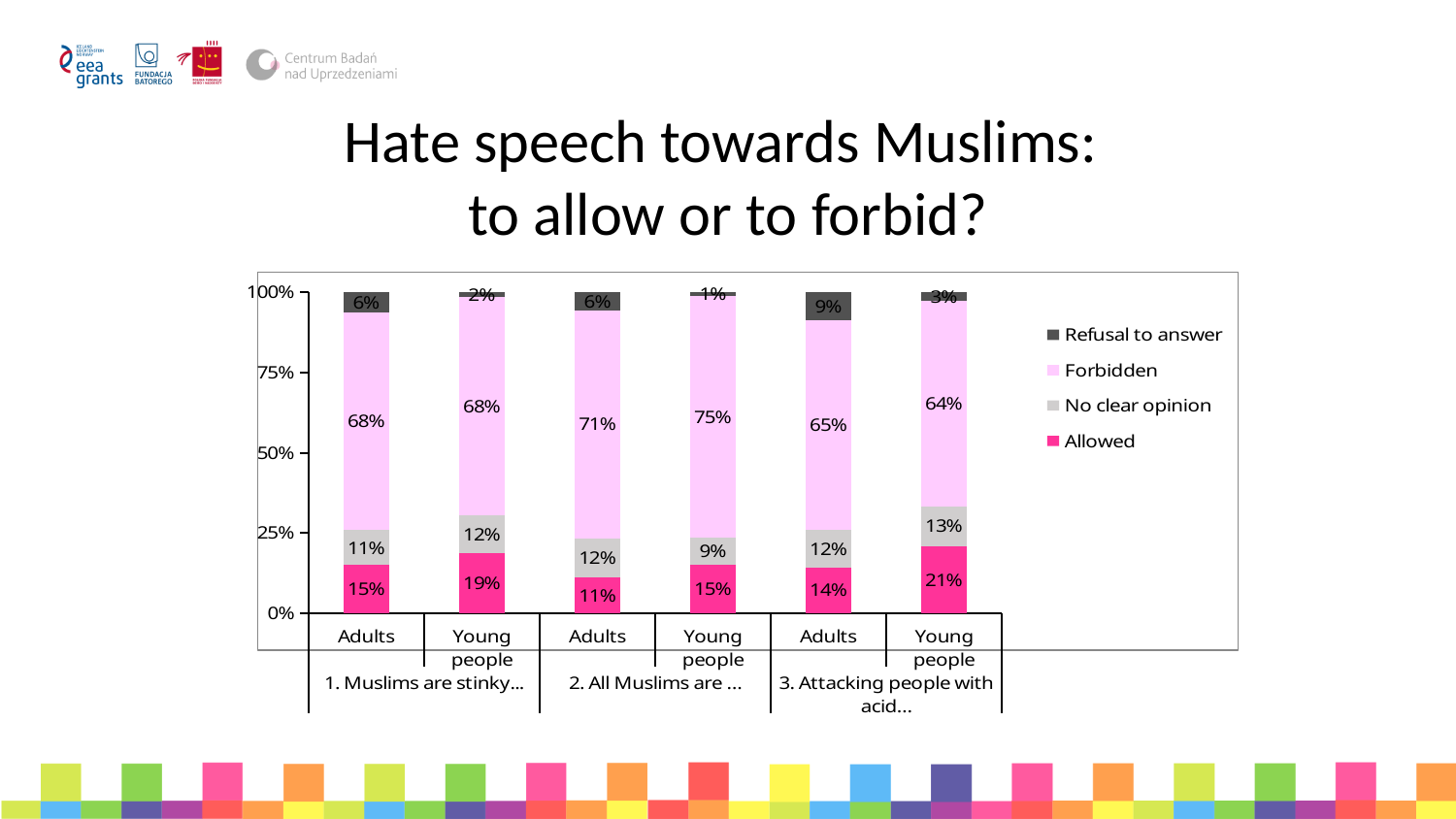
Which group and statement has the lowest 'Allowed' percentage? Adults, 2. All Muslims are ... For statement 2 ("All Muslims are ..."), who has the larger 'Forbidden' share, adults or young people? Young people How much higher is the 'Allowed' share for young people than for adults on statement 3 ("Attacking people with acid...")? 7 percentage points What percentage of young people said statement 3 ("Attacking people with acid...") should be allowed? 21% How many series does the legend list? 4 How many bars are plotted in the chart? 6 What is the 'Refusal to answer' share for adults on statement 3 ("Attacking people with acid...")? 9% What is the 'No clear opinion' share for young people on statement 2 ("All Muslims are ...")? 9% What percentage of adults said hate speech in statement 1 ("Muslims are stinky...") should be forbidden? 68% Which group and statement has the highest 'Forbidden' percentage? Young people, 2. All Muslims are ... Which legend entry is shown in dark grey? Refusal to answer What type of chart is shown on the slide? Stacked bar chart